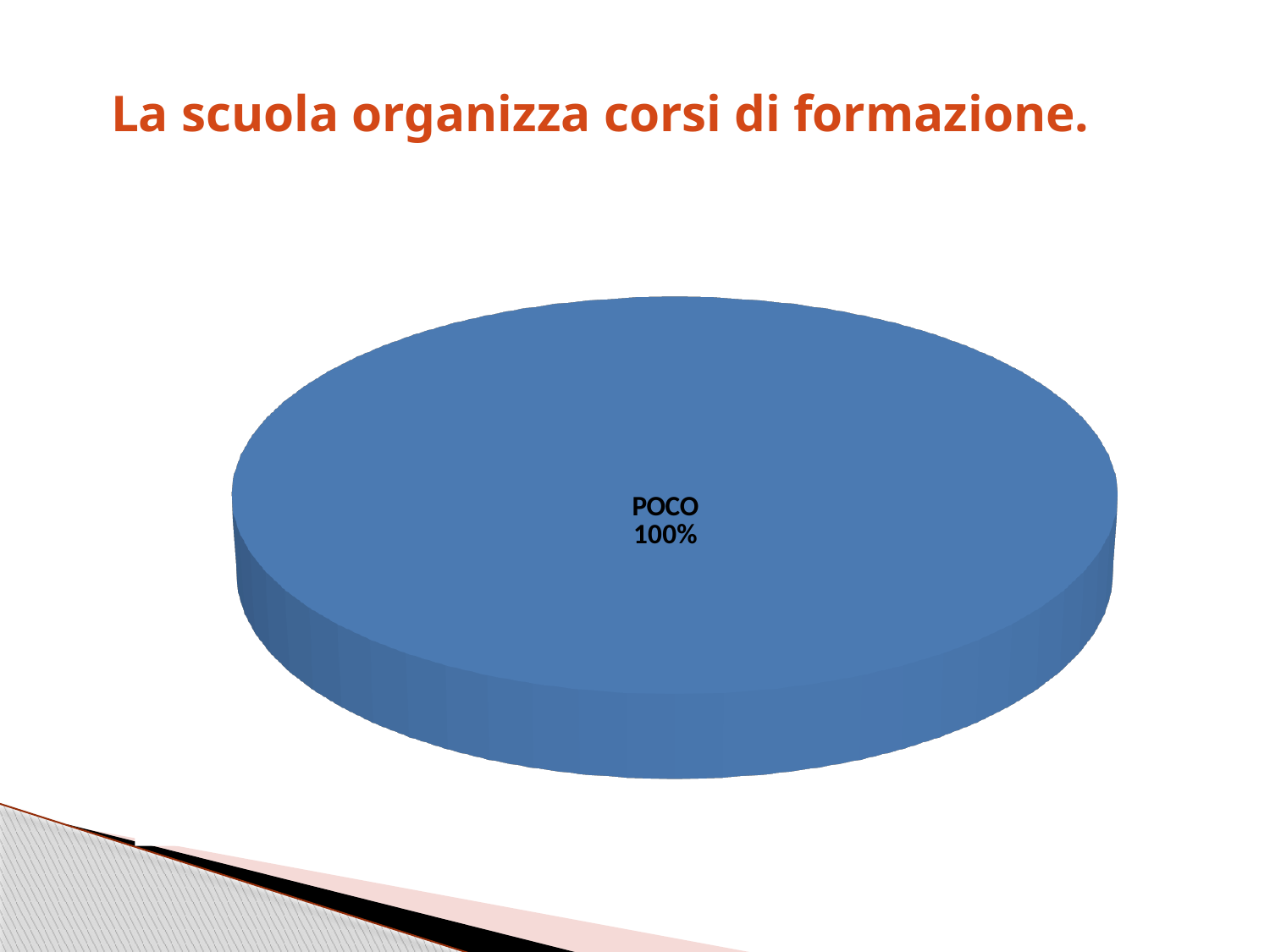
Which category has the largest share of the pie? POCO How many slices does the pie chart have? 1 Is the share for POCO greater or less than 50%? greater What kind of chart is shown on the slide? pie chart What is the label of the only slice in the pie chart? POCO What colour is the POCO slice of the pie chart? blue What is the title of the slide above the chart? La scuola organizza corsi di formazione. What share of the pie does the POCO slice represent? 100%